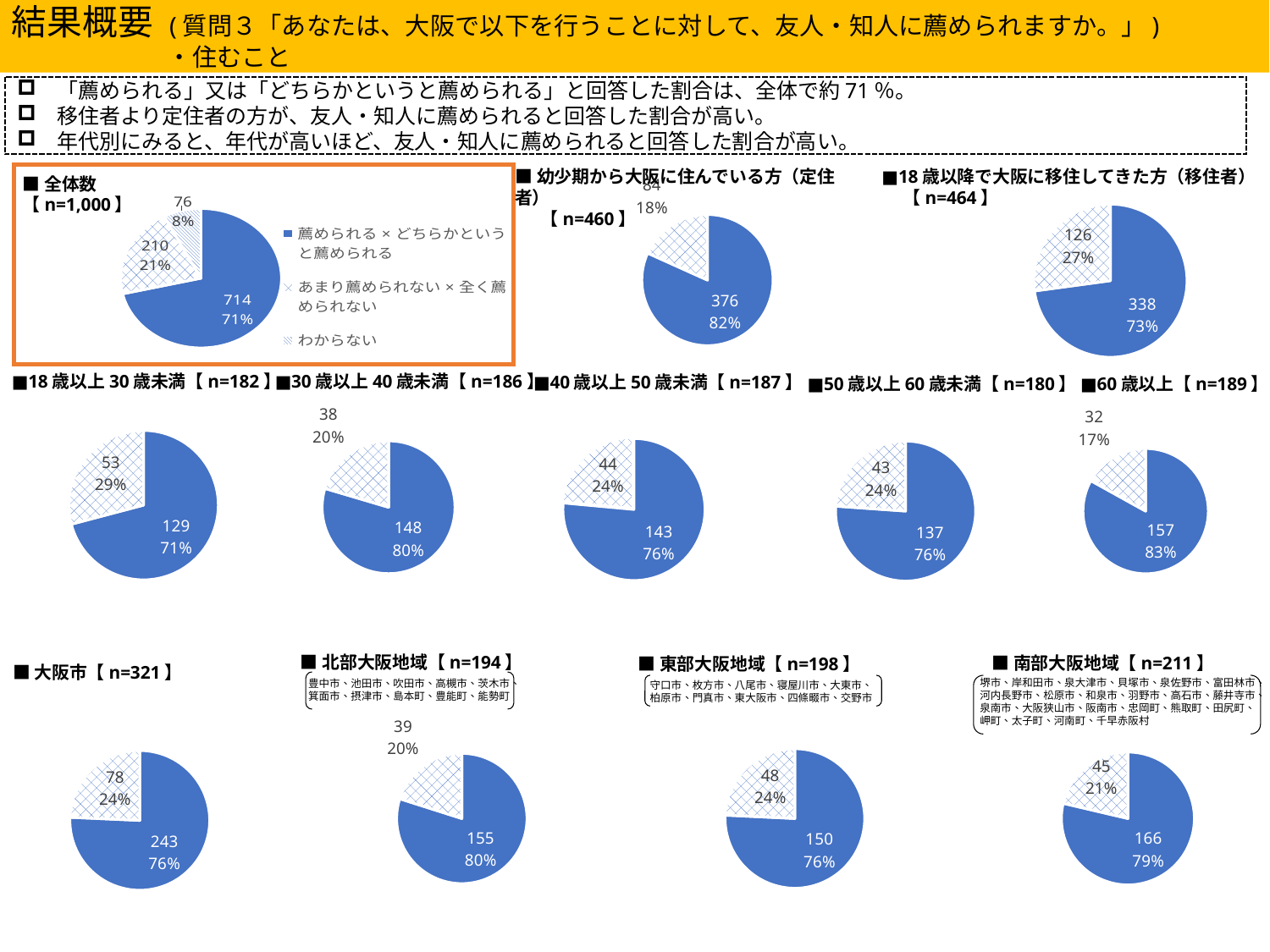
このスライドに使われているグラフの種類は何ですか。 円グラフ 年代別の5つの円グラフのうち、薦められると回答した割合が最も低いのはどの年代ですか。 18歳以上30歳未満 「60歳以上【n=189】」の円グラフで、薦められると回答した人数と薦められないと回答した人数の差はいくつですか。 125 「北部大阪地域【n=194】」の円グラフで、薦められないと回答した人数はいくつですか。 39 年代別の5つの円グラフのうち、薦められると回答した割合が最も高いのはどの年代ですか。 60歳以上 「南部大阪地域【n=211】」の円グラフで、薦められると回答した割合は何%ですか。 79% 「幼少期から大阪に住んでいる方（定住者）」と「18歳以降で大阪に移住してきた方（移住者）」の円グラフで、薦められると回答した割合が高いのはどちらですか。 定住者 「幼少期から大阪に住んでいる方（定住者）【n=460】」の円グラフで、青い部分（薦められる）の割合は何%ですか。 82% 「全体数【n=1,000】」の円グラフで、「薦められる×どちらかというと薦められる」の人数はいくつですか。 714 「18歳以降で大阪に移住してきた方（移住者）【n=464】」の円グラフで、薦められると回答した人数はいくつですか。 338 「全体数【n=1,000】」の円グラフで、「わからない」の割合は何%ですか。 8% 「全体数【n=1,000】」の円グラフの凡例には、いくつの項目がありますか。 3